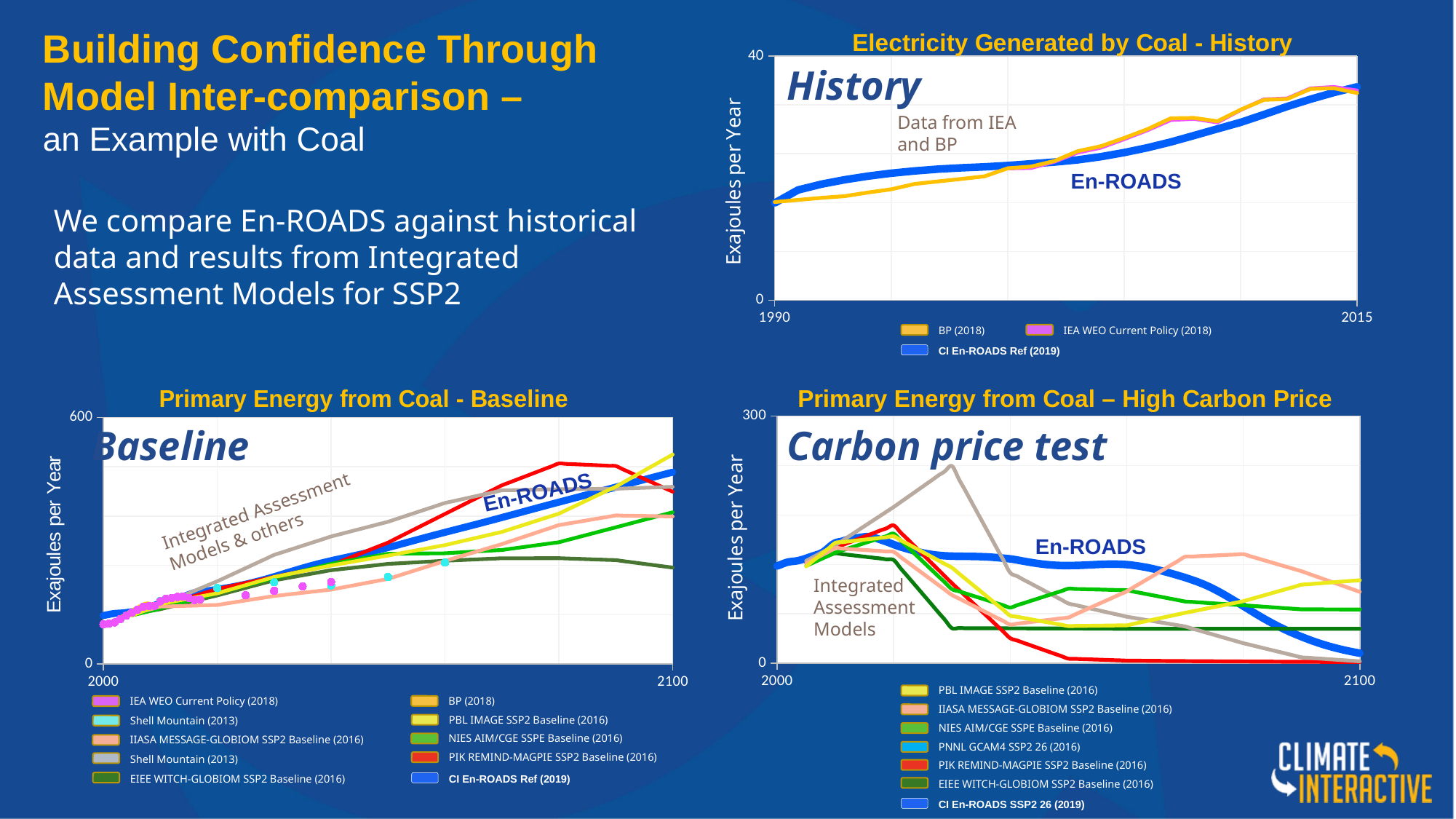
What is the highest value shown on the y-axis of the "Primary Energy from Coal - Baseline" chart? 600 How many series does the legend of the "Primary Energy from Coal - Baseline" chart list? 10 In the "Primary Energy from Coal - Baseline" chart, does the En-ROADS line generally rise or fall from 2000 to 2100? rise In the "Electricity Generated by Coal - History" chart, do the values generally rise or fall from 1990 to 2015? rise What kind of chart is the "Primary Energy from Coal – High Carbon Price" chart? line chart What kind of chart is the "Electricity Generated by Coal - History" chart? line chart How many series does the legend of the "Electricity Generated by Coal - History" chart list? 3 What is the y-axis label of the "Electricity Generated by Coal - History" chart? Exajoules per Year In the "Primary Energy from Coal – High Carbon Price" chart, is the En-ROADS value in 2100 greater or less than 300? less What kind of chart is the "Primary Energy from Coal - Baseline" chart? line chart In the "Primary Energy from Coal – High Carbon Price" chart, does the En-ROADS line rise or fall between 2050 and 2100? fall How many series does the legend of the "Primary Energy from Coal – High Carbon Price" chart list? 7